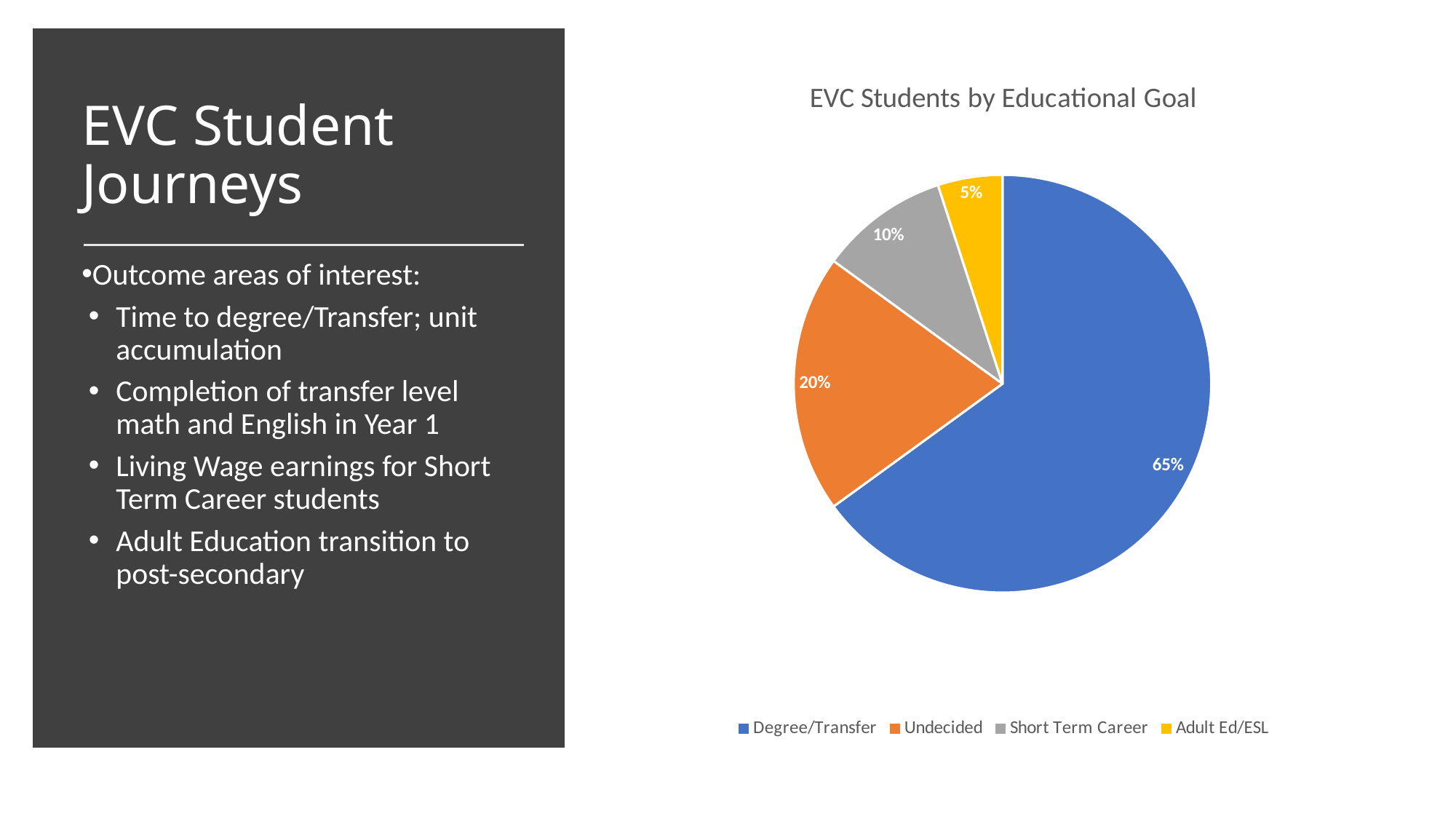
What share of EVC students have Degree/Transfer as their educational goal? 65% What percentage of EVC students are in the Adult Ed/ESL category? 5% Which colour represents the Undecided category in the pie chart? Orange Which educational goal has the smallest share of EVC students? Adult Ed/ESL Which is larger, the Short Term Career share or the Adult Ed/ESL share? Short Term Career What percentage of the pie is labelled Undecided? 20% How many percentage points larger is the Degree/Transfer share than the Undecided share? 45 What share of EVC students have Short Term Career as their educational goal? 10% What is the title of the chart? EVC Students by Educational Goal How many categories does the pie chart show? 4 Which educational goal has the largest share of EVC students? Degree/Transfer What kind of chart is shown on the slide? Pie chart